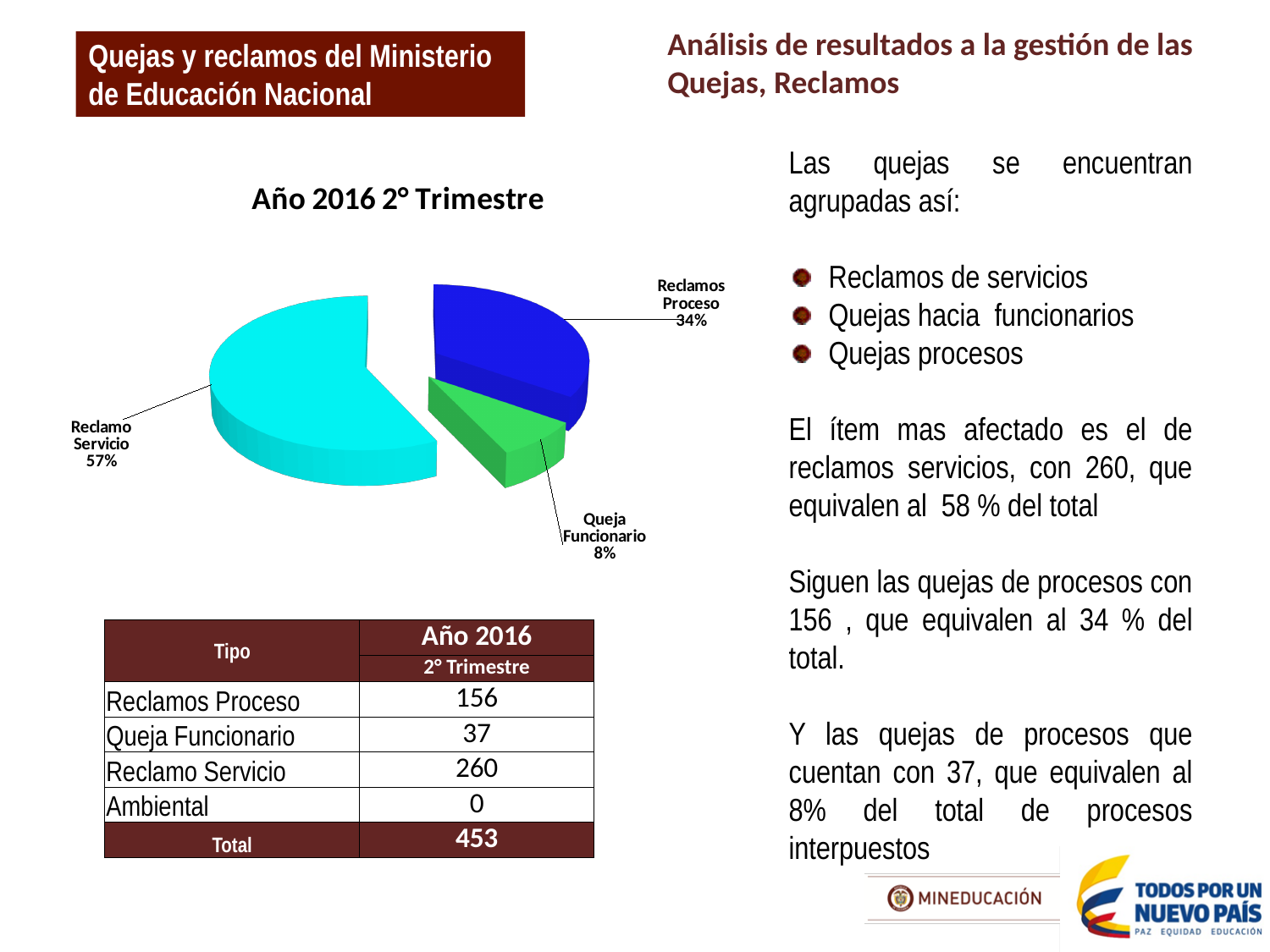
What share of the pie does Reclamo Servicio represent? 57% What is the difference in percentage points between the Reclamo Servicio and Reclamos Proceso slices? 23% How many slices does the pie chart have? 3 What kind of chart is shown on the slide? pie chart What colour is the Reclamo Servicio slice in the pie chart? cyan Which is larger in the pie chart, Reclamos Proceso or Queja Funcionario? Reclamos Proceso Which slice of the pie chart is the largest? Reclamo Servicio What share of the pie does Queja Funcionario represent? 8% What share of the pie does Reclamos Proceso represent? 34% Is the share for Reclamo Servicio greater or less than 50%? greater What is the title of the pie chart? Año 2016 2° Trimestre Which slice of the pie chart is the smallest? Queja Funcionario